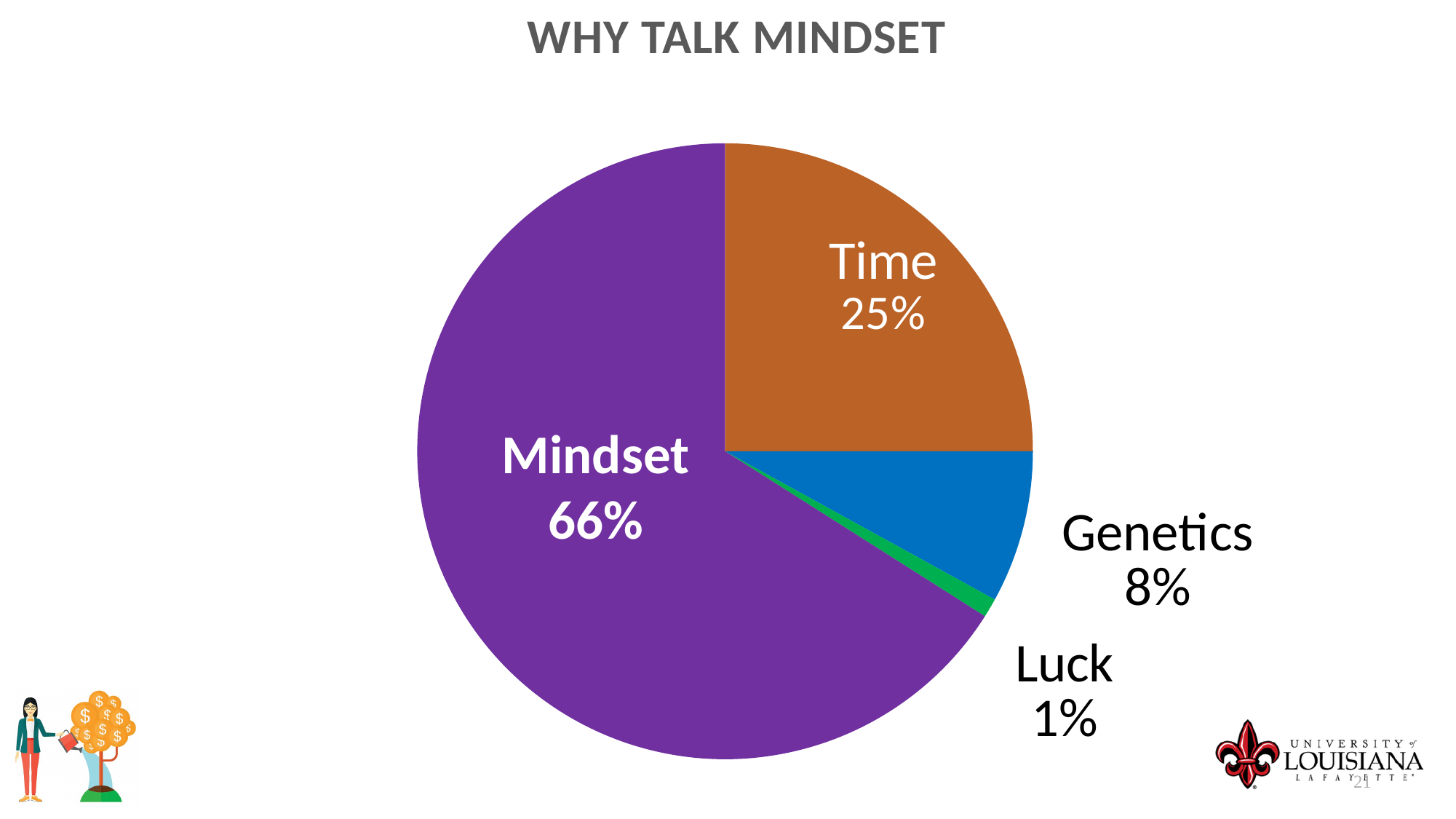
What percentage is shown for Genetics? 8% What percentage is shown for Mindset? 66% Which slice of the pie is the smallest? Luck What is the difference between the Mindset and Time percentages? 41% What colour is the Mindset slice? purple Which is larger, Genetics or Luck? Genetics How many slices does the pie chart have? 4 What percentage is shown for Time? 25% What percentage is shown for Luck? 1% Which slice of the pie is the largest? Mindset What kind of chart is shown on the slide? pie chart What is the title of the slide? WHY TALK MINDSET